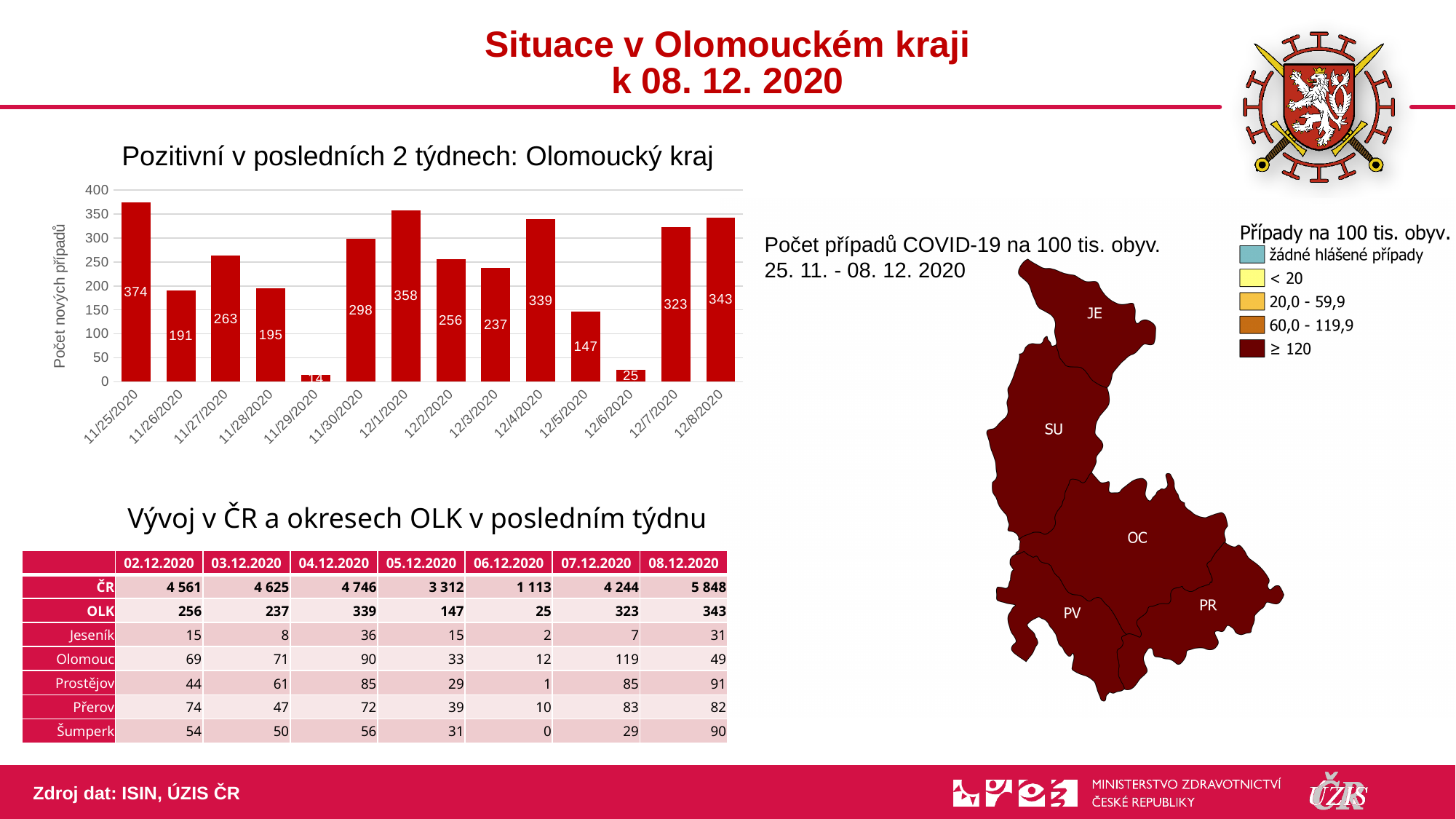
Which date has the lowest value in the bar chart? 11/29/2020 Which date has the highest value in the bar chart? 11/25/2020 What is the value for 12/1/2020 in the bar chart? 358 What is the value for 12/6/2020 in the bar chart? 25 What is the value for 11/25/2020 in the chart 'Pozitivní v posledních 2 týdnech: Olomoucký kraj'? 374 What is the y-axis label of the bar chart? Počet nových případů What is the difference between the values for 12/8/2020 and 12/7/2020 in the bar chart? 20 What is the difference between the values for 11/25/2020 and 11/26/2020 in the bar chart? 183 What kind of chart is 'Pozitivní v posledních 2 týdnech: Olomoucký kraj'? bar chart How many dates (bars) are shown in the bar chart? 14 Is the value for 12/4/2020 in the bar chart greater or less than 300? greater Which is larger in the bar chart, the value for 11/30/2020 or the value for 12/2/2020? 11/30/2020